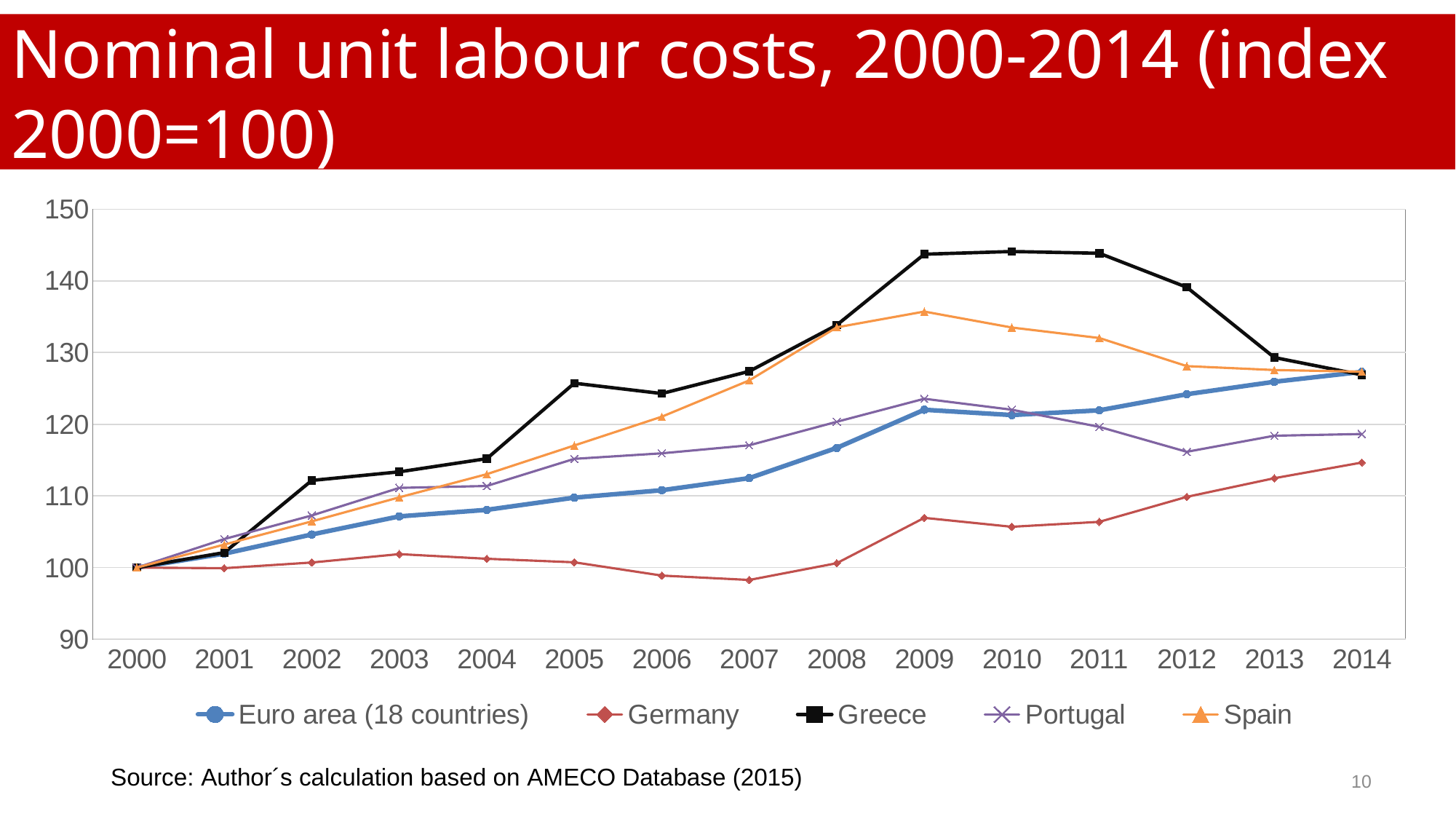
What is the title of the chart? Nominal unit labour costs, 2000-2014 (index 2000=100) Is the value for Germany in 2007 greater or less than 100? less What kind of chart is shown on the slide? line chart What is the value for Greece in 2000? 100 How many years are plotted along the x axis? 15 Is the value for Spain in 2009 greater or less than 130? greater Which is higher in 2008, Spain or Portugal? Spain Which series has the lowest value in 2014? Germany Does the value for Greece rise or fall from 2011 to 2014? fall Is the value for Greece in 2009 greater or less than 140? greater Which series has the highest value in 2010? Greece How many series does the legend list? 5